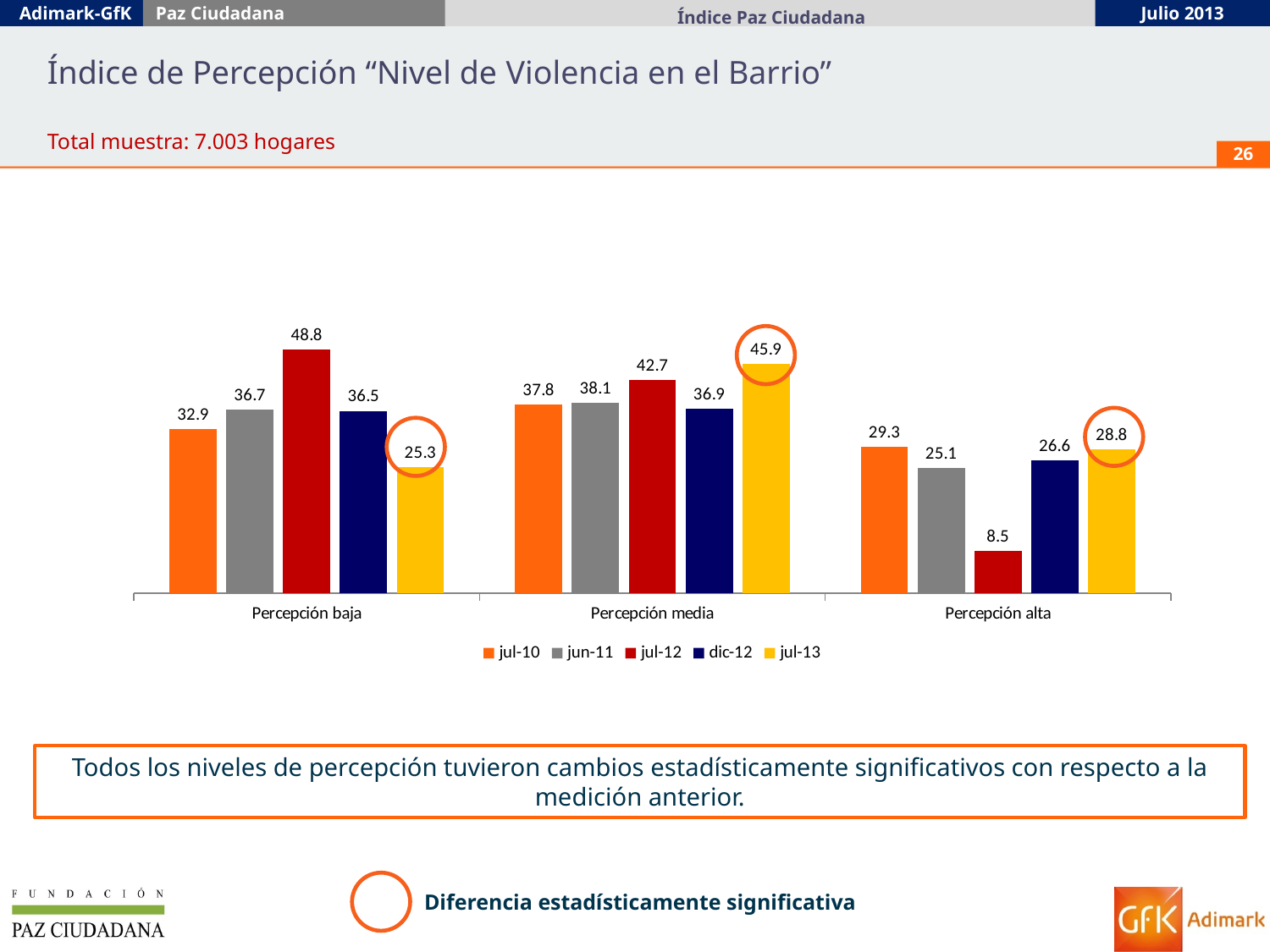
What kind of chart is shown on the slide? bar chart What is the difference between the jul-12 and jul-13 values in the Percepción baja category? 23.5 Which is larger in the Percepción alta category: the jul-10 value or the jul-13 value? jul-10 What is the value for jul-13 in the Percepción baja category? 25.3 How many series does the legend list? 5 Which series has the highest value in the Percepción baja category? jul-12 Which series has the lowest value in the Percepción alta category? jul-12 What is the difference between the jul-13 and dic-12 values in the Percepción media category? 9.0 What is the value for jul-12 in the Percepción alta category? 8.5 What is the value for dic-12 in the Percepción media category? 36.9 How many categories are shown on the x axis? 3 Which colour represents the jul-13 series in the legend? yellow